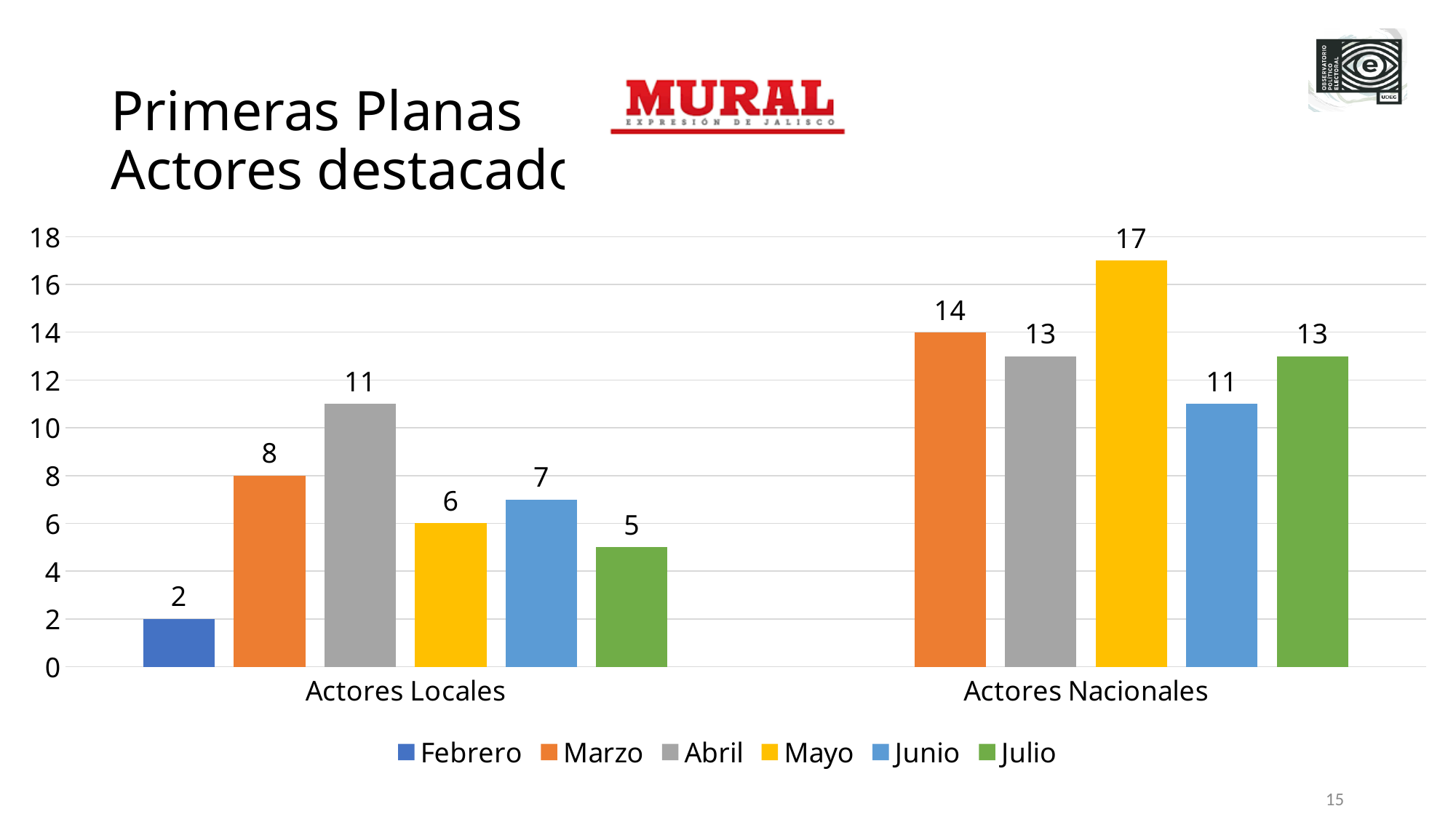
What is the value for Abril in the Actores Locales group? 11 What is the value for Febrero in the Actores Locales group? 2 Which month is missing a bar in the Actores Nacionales group? Febrero How many category groups are shown on the x axis? 2 What colour are the Mayo bars? Yellow What kind of chart is shown on the slide? Bar chart Which month has the highest value in the Actores Nacionales group? Mayo Which month has the lowest value in the Actores Locales group? Febrero What is the value for Mayo in the Actores Nacionales group? 17 How many series does the legend list? 6 Which is larger: the Junio value for Actores Locales or the Julio value for Actores Locales? Junio What is the difference between the Marzo values for Actores Nacionales and Actores Locales? 6